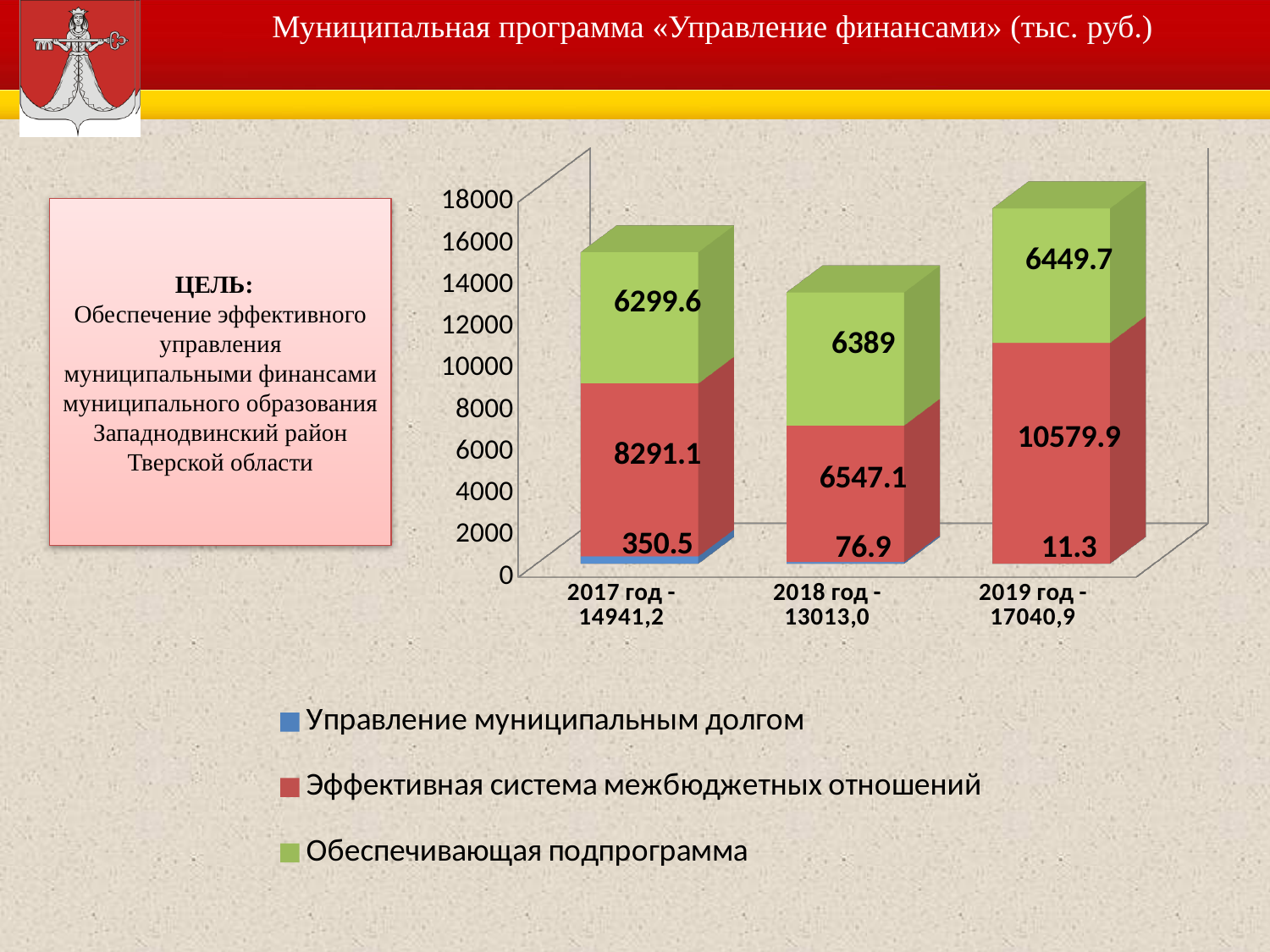
Which colour represents Обеспечивающая подпрограмма in the chart? Green What is the value of Управление муниципальным долгом for 2017 год? 350.5 What is the difference between the Обеспечивающая подпрограмма values for 2019 год and 2017 год? 150.1 How many series does the legend list? 3 In which year is the value of Эффективная система межбюджетных отношений highest? 2019 год What is the total of the stacked bar for 2018 год? 13013,0 How many years are shown on the x axis? 3 Which is larger: Эффективная система межбюджетных отношений in 2017 год or in 2018 год? 2017 год What kind of chart is shown on the slide? Stacked bar chart What is the value of Обеспечивающая подпрограмма for 2018 год? 6389 What is the value of Эффективная система межбюджетных отношений for 2019 год? 10579.9 In which year is the value of Управление муниципальным долгом lowest? 2019 год